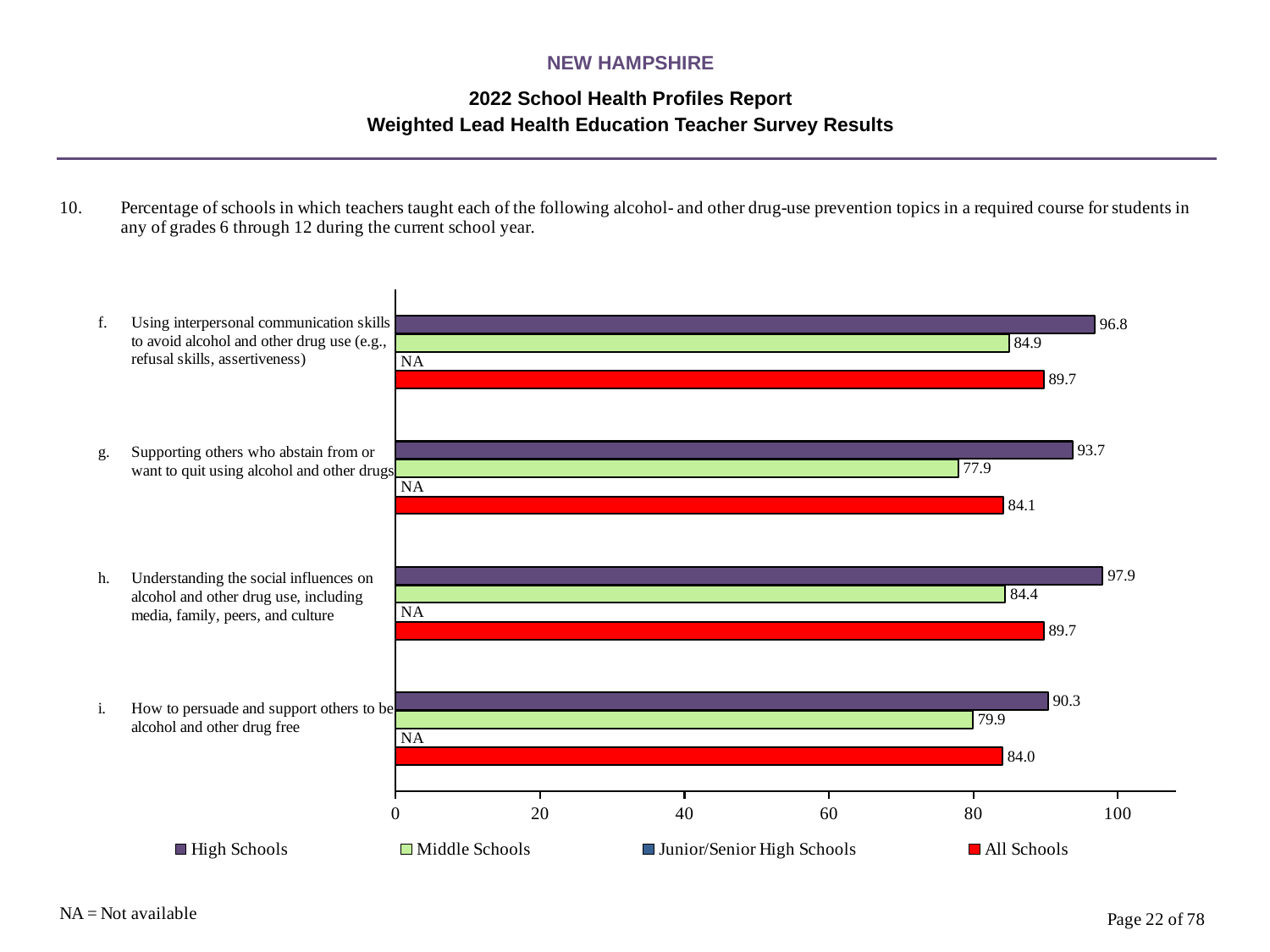
Is the Middle Schools value for topic h, understanding the social influences on alcohol and other drug use, greater or less than 80? greater What kind of chart is shown on the slide? Bar chart How many series does the legend list? 4 What is the difference between the High Schools and Middle Schools values for topic f, using interpersonal communication skills? 11.9 What is the All Schools value for topic i, how to persuade and support others to be alcohol and other drug free? 84.0 For topic i, how to persuade and support others to be alcohol and other drug free, which is larger: the High Schools value or the All Schools value? High Schools How many topics are plotted on the chart? 4 What is the Middle Schools value for topic g, supporting others who abstain from or want to quit using alcohol and other drugs? 77.9 What is the High Schools value for topic h, understanding the social influences on alcohol and other drug use? 97.9 Which topic has the highest High Schools value? h. Understanding the social influences on alcohol and other drug use, including media, family, peers, and culture What is shown for Junior/Senior High Schools for topic f, using interpersonal communication skills to avoid alcohol and other drug use? NA Which topic has the lowest Middle Schools value? g. Supporting others who abstain from or want to quit using alcohol and other drugs